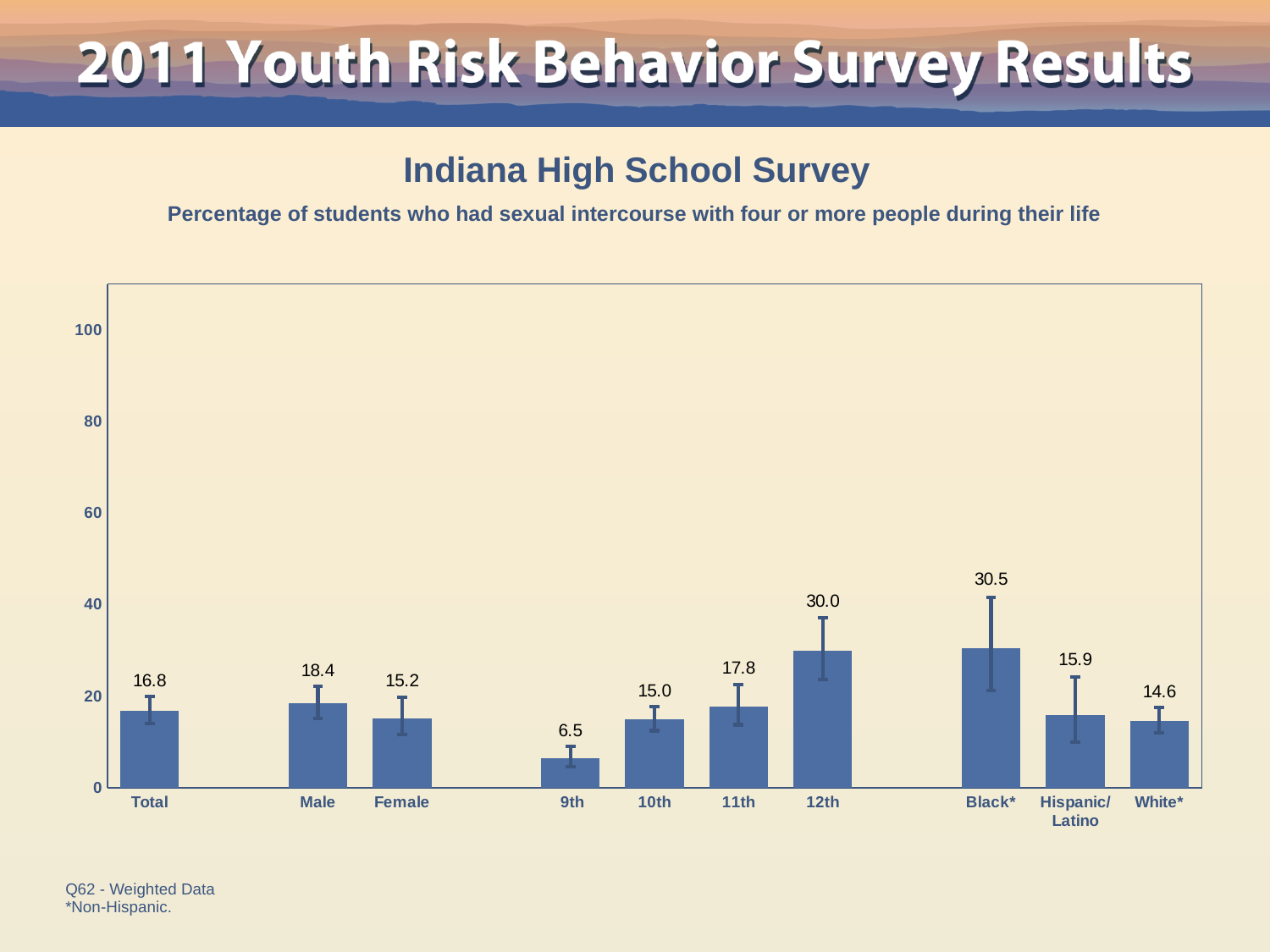
Which category has the highest value? Black* What is the value for Hispanic/Latino students? 15.9 What is the value for 12th grade students? 30.0 Is the value for 12th greater or less than 20? greater What is the title of the chart? Indiana High School Survey How many categories are shown on the x axis? 10 Which category has the lowest value? 9th Which is larger, the value for 11th or the value for 10th? 11th What is the difference between the values for Male and Female? 3.2 What kind of chart is shown? bar chart What is the value for Total? 16.8 Do the values rise or fall from 9th to 12th grade? rise